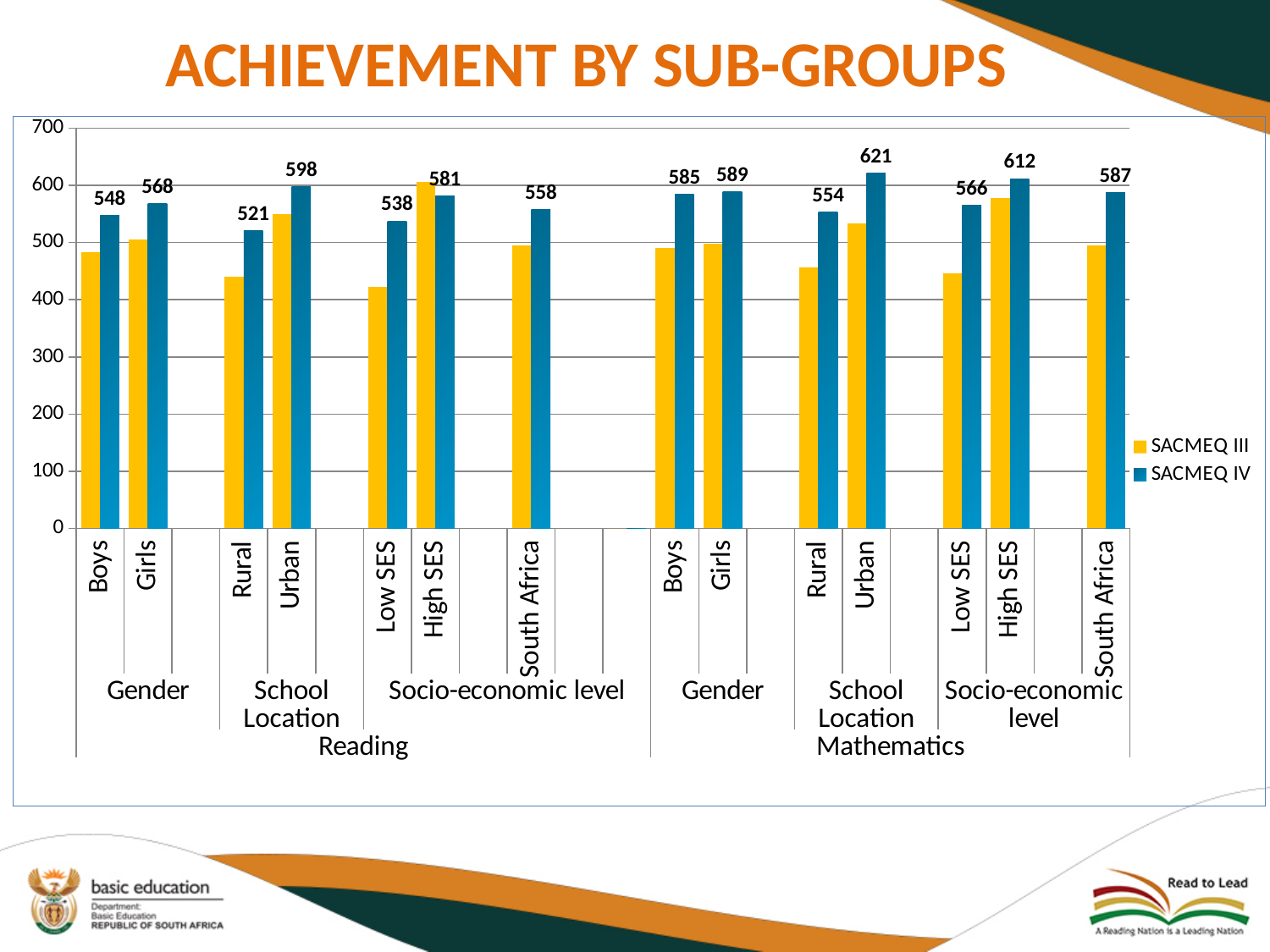
Which sub-group has the lowest SACMEQ IV value on the chart? Rural (Reading) Is the SACMEQ III value for Low SES under Reading greater or less than 500? less Which sub-group has the highest SACMEQ IV value on the chart? Urban (Mathematics) Which is larger for SACMEQ IV: High SES under Reading or Low SES under Mathematics? High SES under Reading What is the difference between the SACMEQ IV values for Girls and Boys under Reading? 20 What is the SACMEQ IV value for Urban under Reading? 598 What is the difference between the SACMEQ IV values for Urban and Rural under Mathematics? 67 What kind of chart is shown on the slide? Bar chart What is the SACMEQ IV value for High SES under Mathematics? 612 Is the SACMEQ III value for Urban under Mathematics greater or less than 500? greater How many series does the legend list? 2 What is the SACMEQ IV value for South Africa under Mathematics? 587